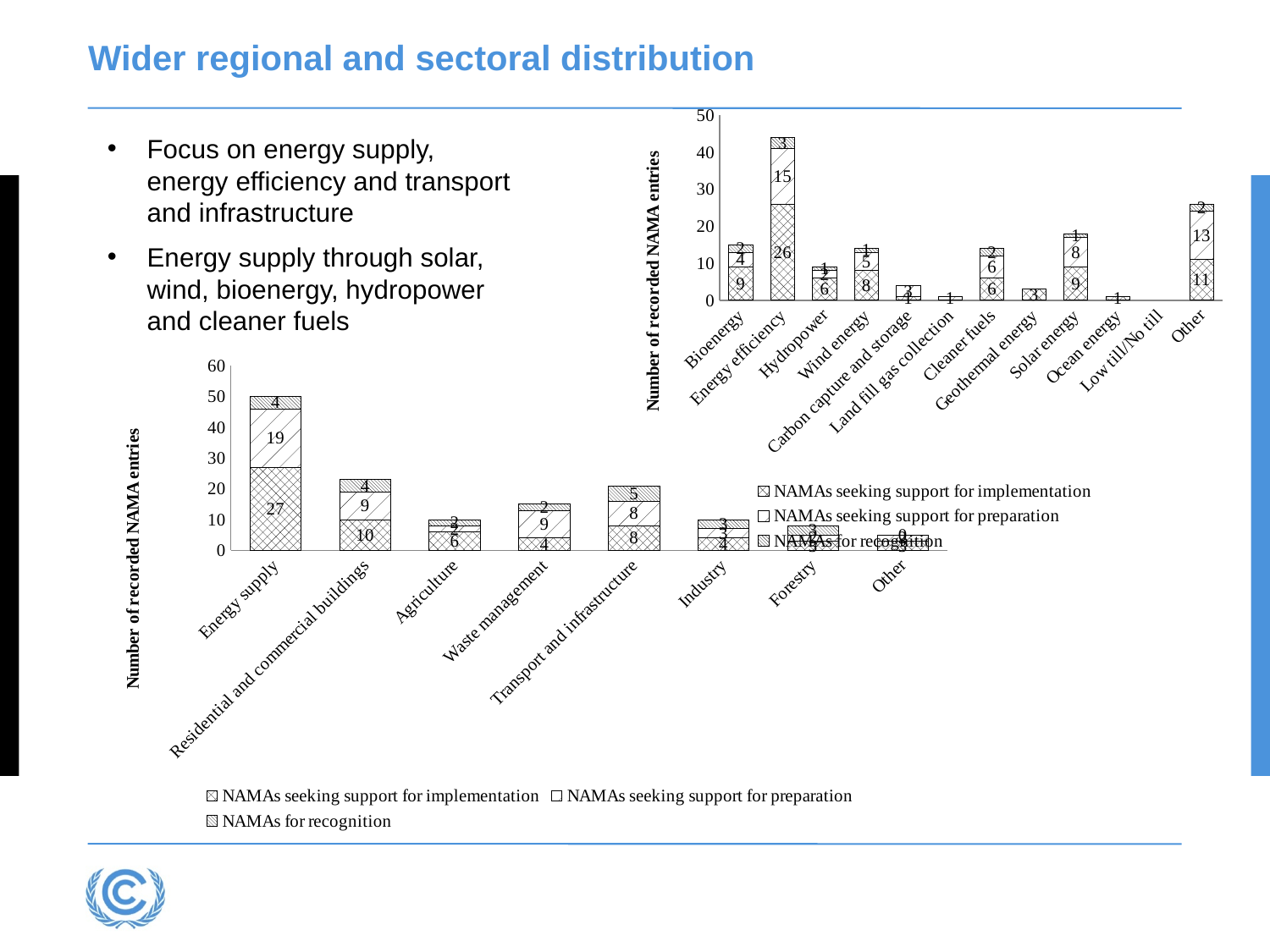
In the bottom-left chart, what is the total number of recorded NAMA entries for Energy supply? 50 In the bottom-left chart, how many NAMAs seeking support for implementation are recorded for Energy supply? 27 In the bottom-left chart, which sector has the highest total number of recorded NAMA entries? Energy supply What kind of chart is the bottom-left chart? Stacked bar chart In the bottom-left chart, how many NAMAs seeking support for preparation are recorded for Energy supply? 19 In the top-right chart, is the total for Energy efficiency greater or less than 40? greater In the top-right chart, which has more NAMAs seeking support for implementation, Bioenergy or Hydropower? Bioenergy In the top-right chart, which category has the highest total number of recorded NAMA entries? Energy efficiency In the bottom-left chart, how many series does the legend list? 3 In the top-right chart, how many NAMAs seeking support for implementation are recorded for Energy efficiency? 26 In the top-right chart, how many NAMAs seeking support for preparation are recorded for Other? 13 In the bottom-left chart, how many NAMAs seeking support for implementation are recorded for Residential and commercial buildings? 10